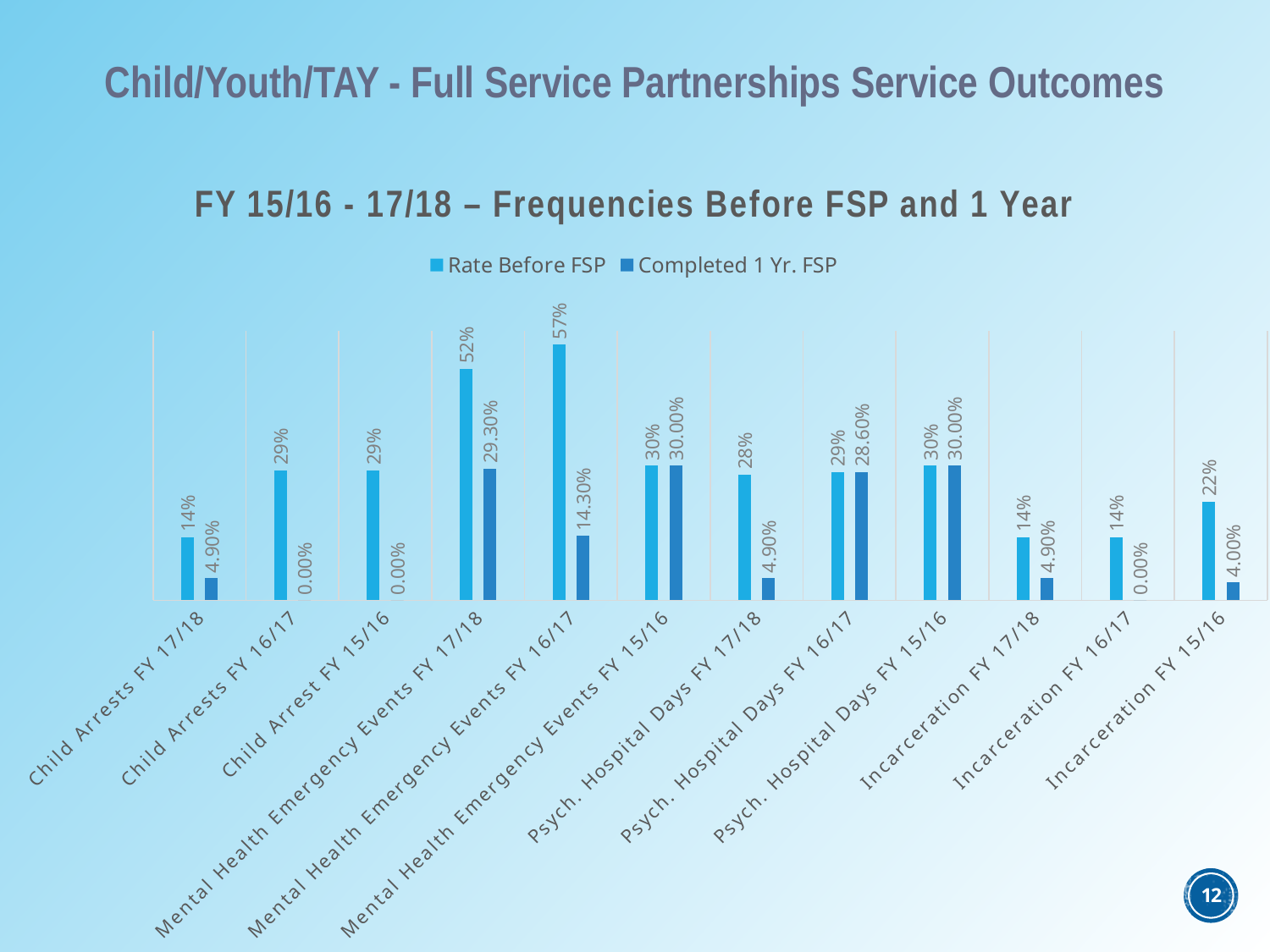
Which is larger: the Completed 1 Yr. FSP value for Mental Health Emergency Events FY 17/18 or for Mental Health Emergency Events FY 16/17? Mental Health Emergency Events FY 17/18 How many series does the chart legend list? 2 What is the Rate Before FSP value for Incarceration FY 15/16? 22% What is the Completed 1 Yr. FSP value for Psych. Hospital Days FY 16/17? 28.60% Which category has the highest Rate Before FSP value? Mental Health Emergency Events FY 16/17 What is the difference between the Rate Before FSP values for Mental Health Emergency Events FY 16/17 and FY 17/18? 5% What is the Rate Before FSP value for Mental Health Emergency Events FY 16/17? 57% What is the Completed 1 Yr. FSP value for Mental Health Emergency Events FY 17/18? 29.30% What is the difference between the Rate Before FSP and Completed 1 Yr. FSP values for Incarceration FY 15/16? 18% How many categories are shown on the x axis of the chart? 12 What is the Completed 1 Yr. FSP value for Incarceration FY 16/17? 0.00% What kind of chart is shown on the slide? Bar chart